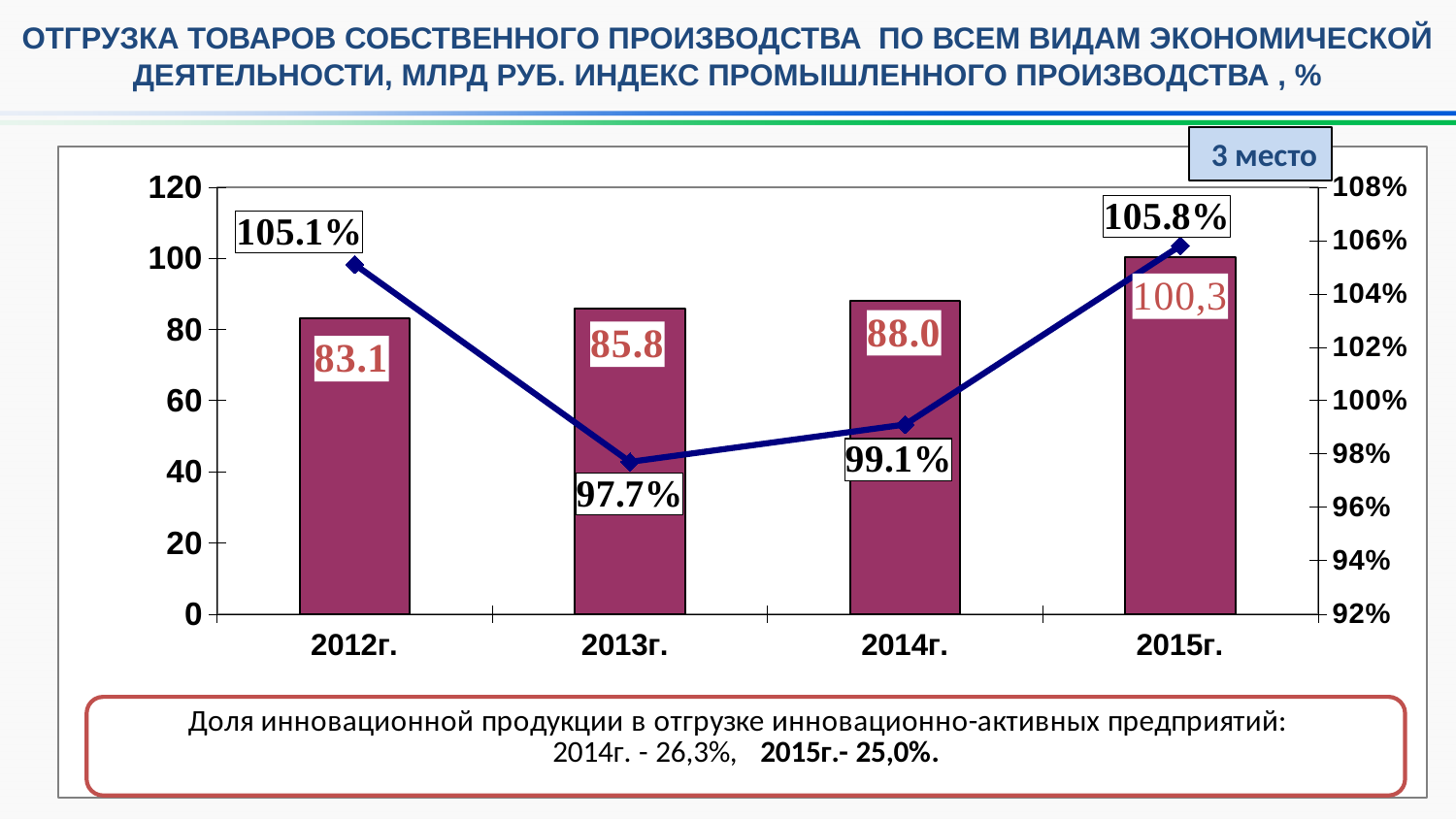
What is the difference between the bar values for 2014г. and 2013г.? 2.2 How many years are shown on the x axis? 4 What kind of chart is shown on the slide? Combined bar and line chart Which year has the highest bar value? 2015г. Is the bar value for 2013г. greater or less than 100? less What is the shipment value (bar) for 2015г.? 100,3 What is the industrial production index (line) for 2013г.? 97.7% Which is larger, the industrial production index for 2012г. or for 2014г.? 2012г. Do the bar values rise or fall from 2012г. to 2015г.? rise Which year has the lowest industrial production index on the line? 2013г. What is the industrial production index (line) for 2015г.? 105.8% What is the shipment value (bar) for 2012г.? 83.1